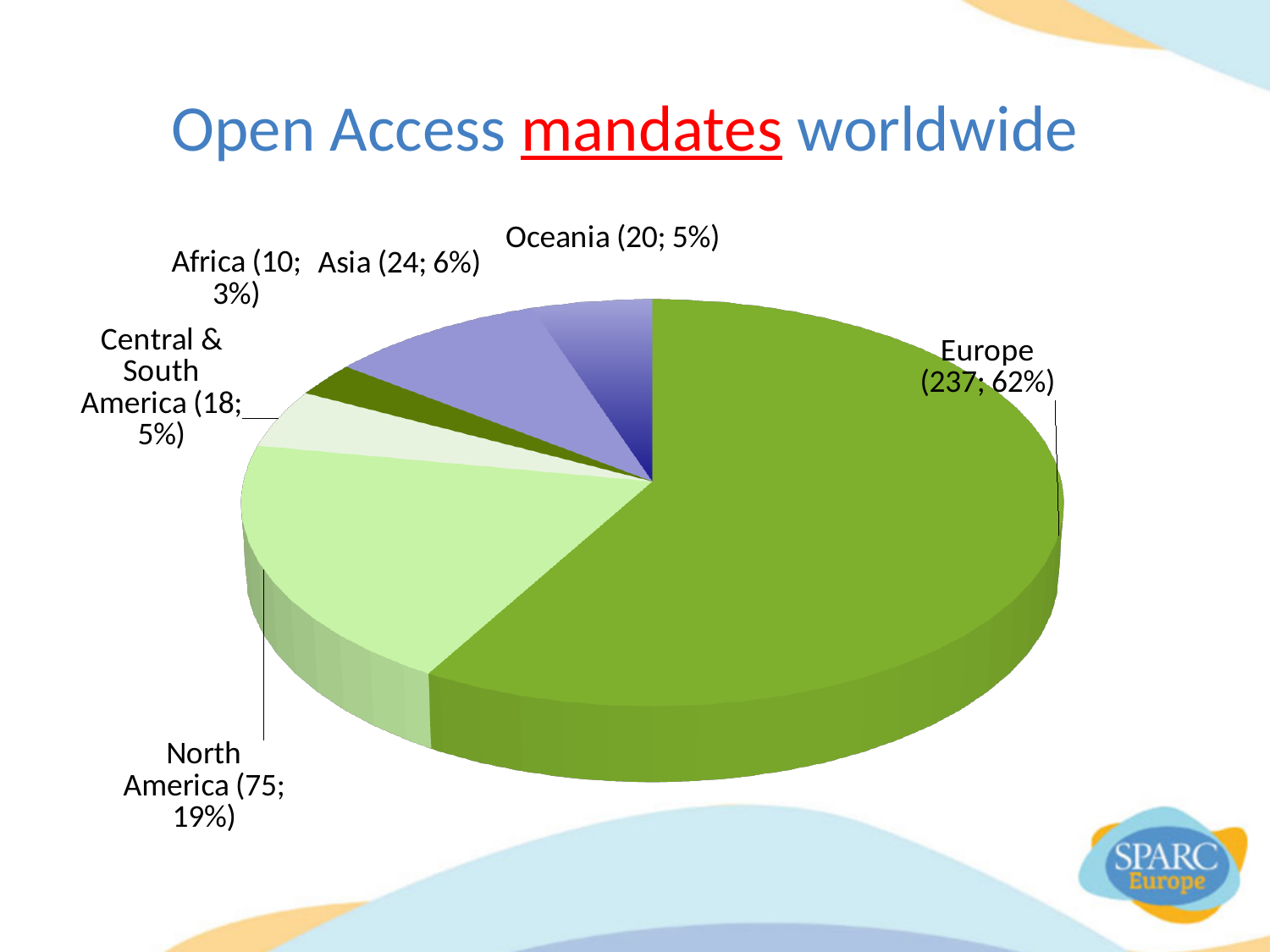
Which region has the smallest slice of the pie? Africa How many regions (slices) are shown in the pie chart? 6 Which has more mandates, Asia or Oceania? Asia What percentage of the pie is Africa? 3% How many mandates does Asia have? 24 How many mandates does Central & South America have? 18 What is the title of the chart? Open Access mandates worldwide Which region has the largest slice of the pie? Europe What kind of chart is shown on the slide? pie chart How many Open Access mandates does Europe have? 237 What is the difference in mandates between Europe and North America? 162 What share of the pie does North America represent? 19%